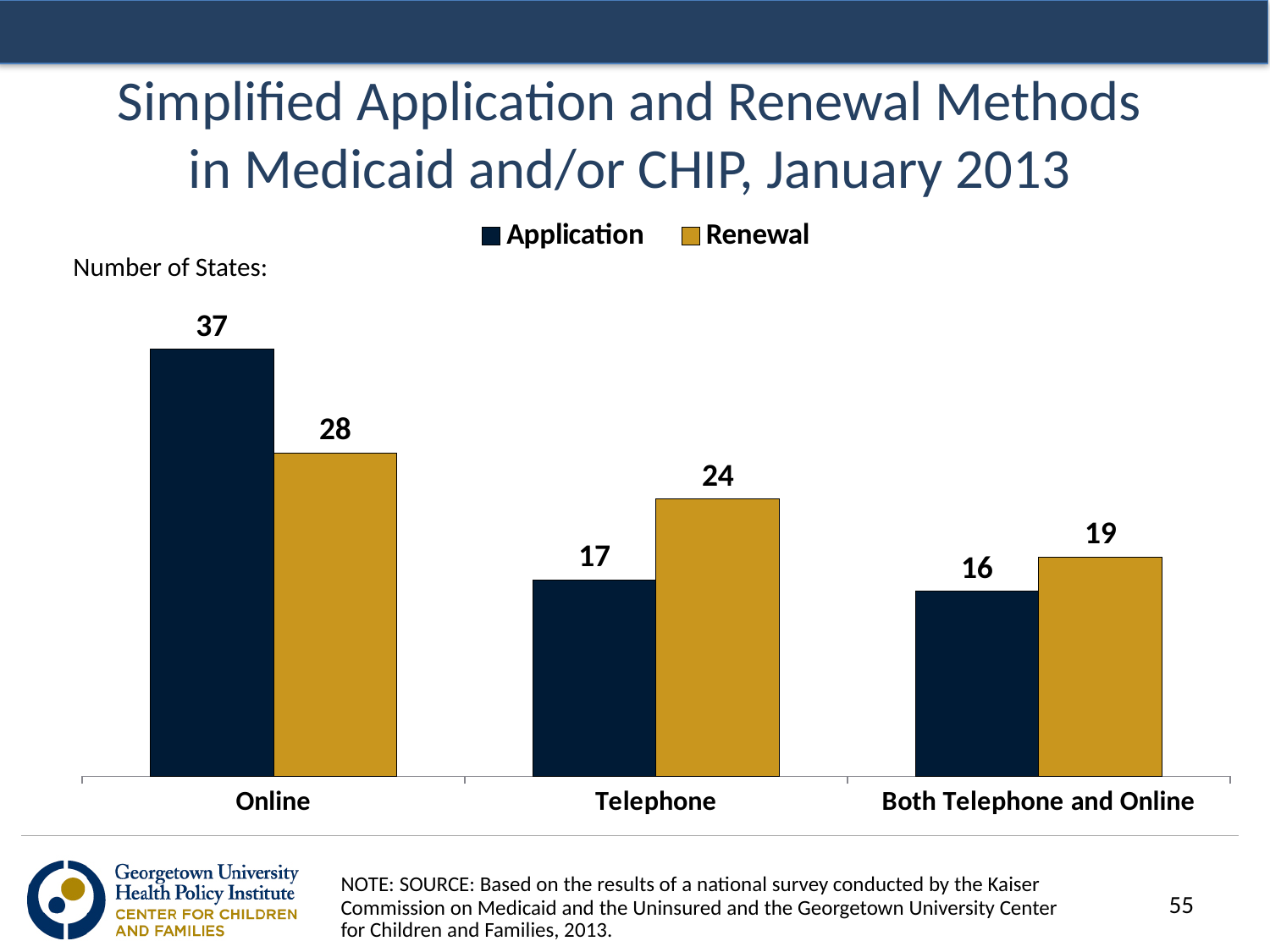
What is the Renewal value for Telephone? 24 What is the difference between the Renewal values for Telephone and Both Telephone and Online? 5 What does the chart measure, according to the label above the plot area? Number of States What is the Application value for Both Telephone and Online? 16 How many categories are shown on the x axis? 3 Which category has the lowest Renewal value? Both Telephone and Online How many states offer online applications according to the chart? 37 What kind of chart is shown on the slide? Bar chart Which category has the highest Application value? Online How many series does the legend list? 2 For Telephone, which is larger: the Application value or the Renewal value? Renewal What is the difference between the Application and Renewal values for Online? 9